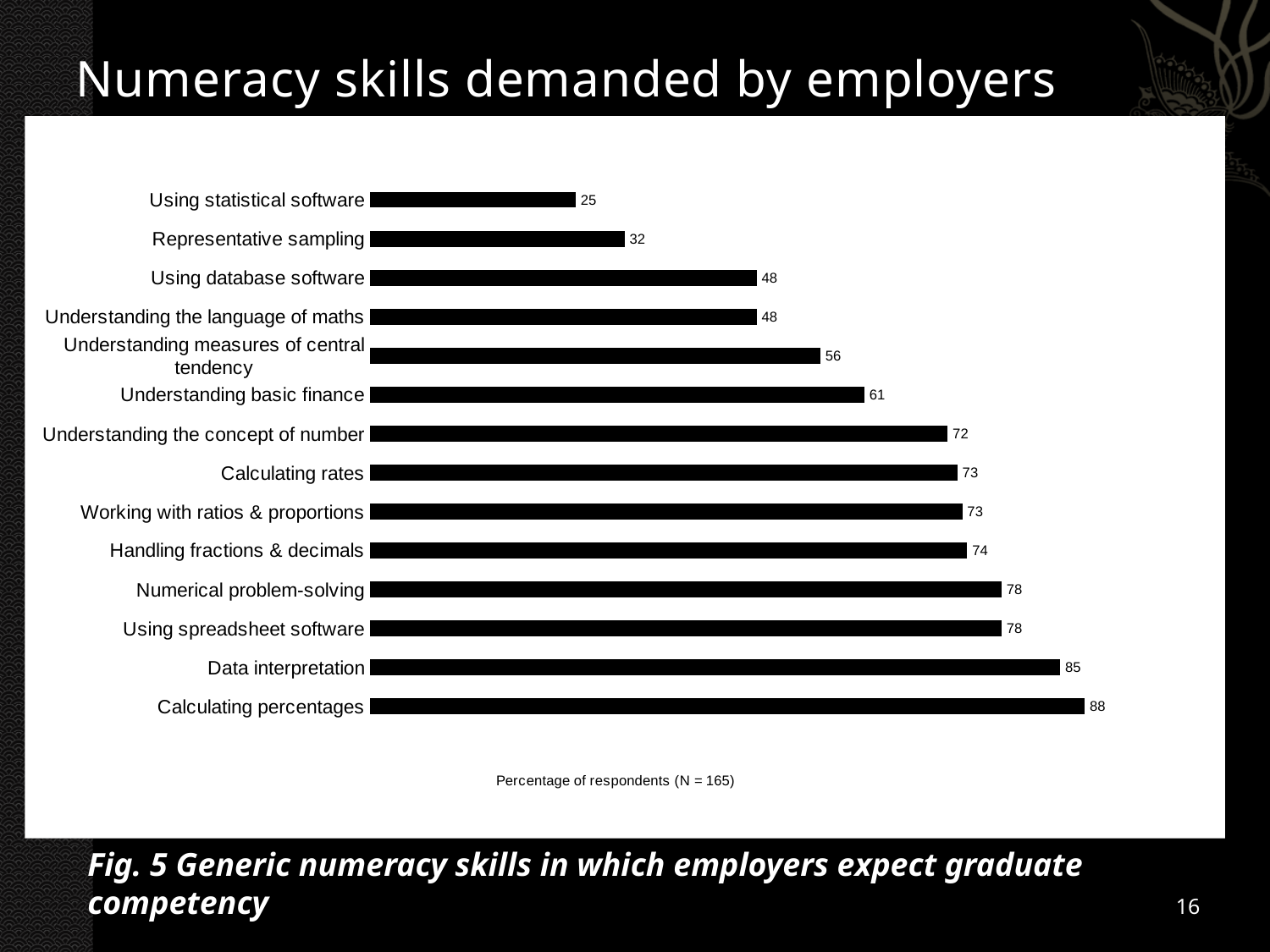
Which category has the highest value? Calculating percentages Which is larger, the value for Numerical problem-solving or the value for Understanding the concept of number? Numerical problem-solving What is the difference between the values for Data interpretation and Representative sampling? 53 Which category has the lowest value? Using statistical software What is the value for Using statistical software? 25 What is the value for Calculating percentages? 88 How many categories are shown in the chart? 14 What kind of chart is shown on the slide? Bar chart What is the value for Understanding basic finance? 61 What is the difference between the values for Using spreadsheet software and Using database software? 30 What is the value for Understanding measures of central tendency? 56 What is the x-axis label of the chart? Percentage of respondents (N = 165)